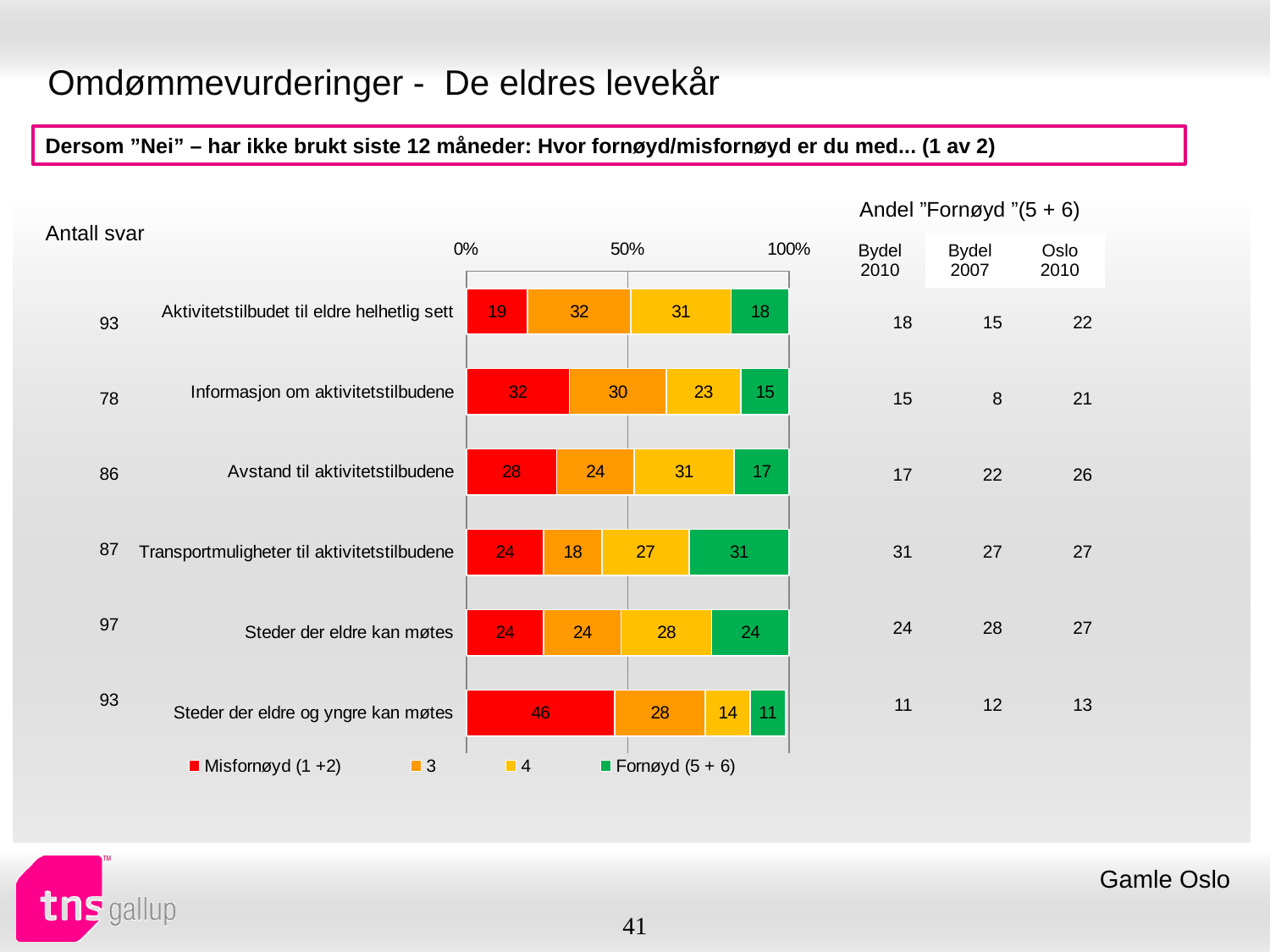
What is the Fornøyd (5 + 6) value for 'Transportmuligheter til aktivitetstilbudene'? 31 Which category has the lowest Fornøyd (5 + 6) value? Steder der eldre og yngre kan møtes Which category has the highest Misfornøyd (1 +2) value? Steder der eldre og yngre kan møtes What is the total of the stacked bar for 'Aktivitetstilbudet til eldre helhetlig sett'? 100 How many categories are plotted in the chart? 6 What is the difference between the Misfornøyd (1 +2) values for 'Informasjon om aktivitetstilbudene' and 'Aktivitetstilbudet til eldre helhetlig sett'? 13 What colour represents the Fornøyd (5 + 6) series in the chart? Green What is the value of series '4' for 'Informasjon om aktivitetstilbudene'? 23 What is the Misfornøyd (1 +2) value for 'Steder der eldre og yngre kan møtes'? 46 What kind of chart is shown on the slide? Stacked bar chart How many series does the chart legend list? 4 Which is larger: the Fornøyd (5 + 6) value for 'Steder der eldre kan møtes' or for 'Avstand til aktivitetstilbudene'? Steder der eldre kan møtes